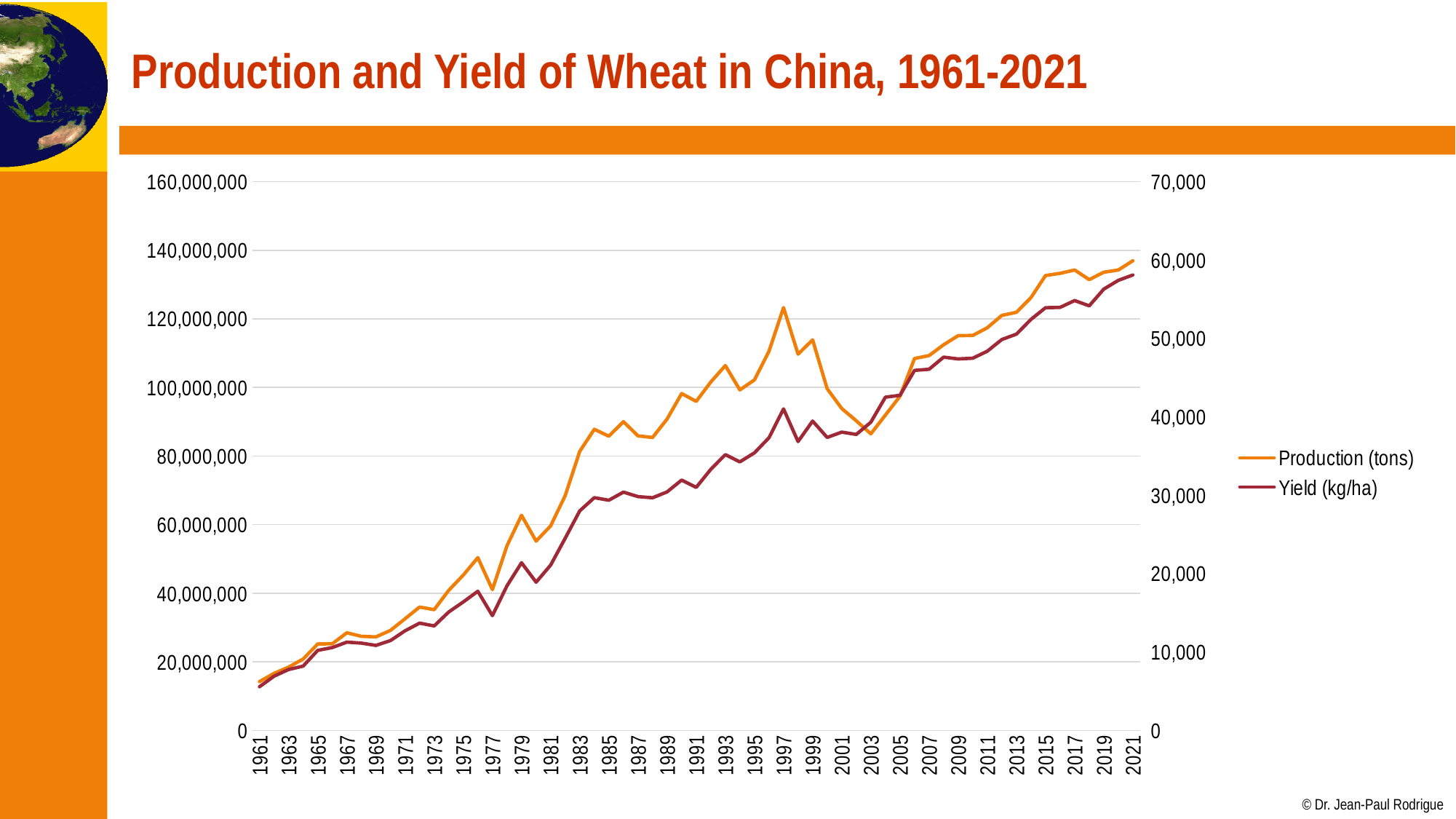
In which year is wheat production lowest? 1961 In which year is wheat production highest? 2021 What kind of chart is shown on the slide? line chart What are the two series named in the legend? Production (tons) and Yield (kg/ha) Which year has higher wheat production, 1997 or 2003? 1997 How many series does the legend list? 2 Is the value for Yield (kg/ha) in 1977 greater or less than 20,000? less What is the title of the chart on the slide? Production and Yield of Wheat in China, 1961-2021 Is the value for Production (tons) in 2003 greater or less than 100,000,000? less Is the value for Yield (kg/ha) in 2021 greater or less than 50,000? greater Overall, does wheat production rise or fall from 1961 to 2021? rise